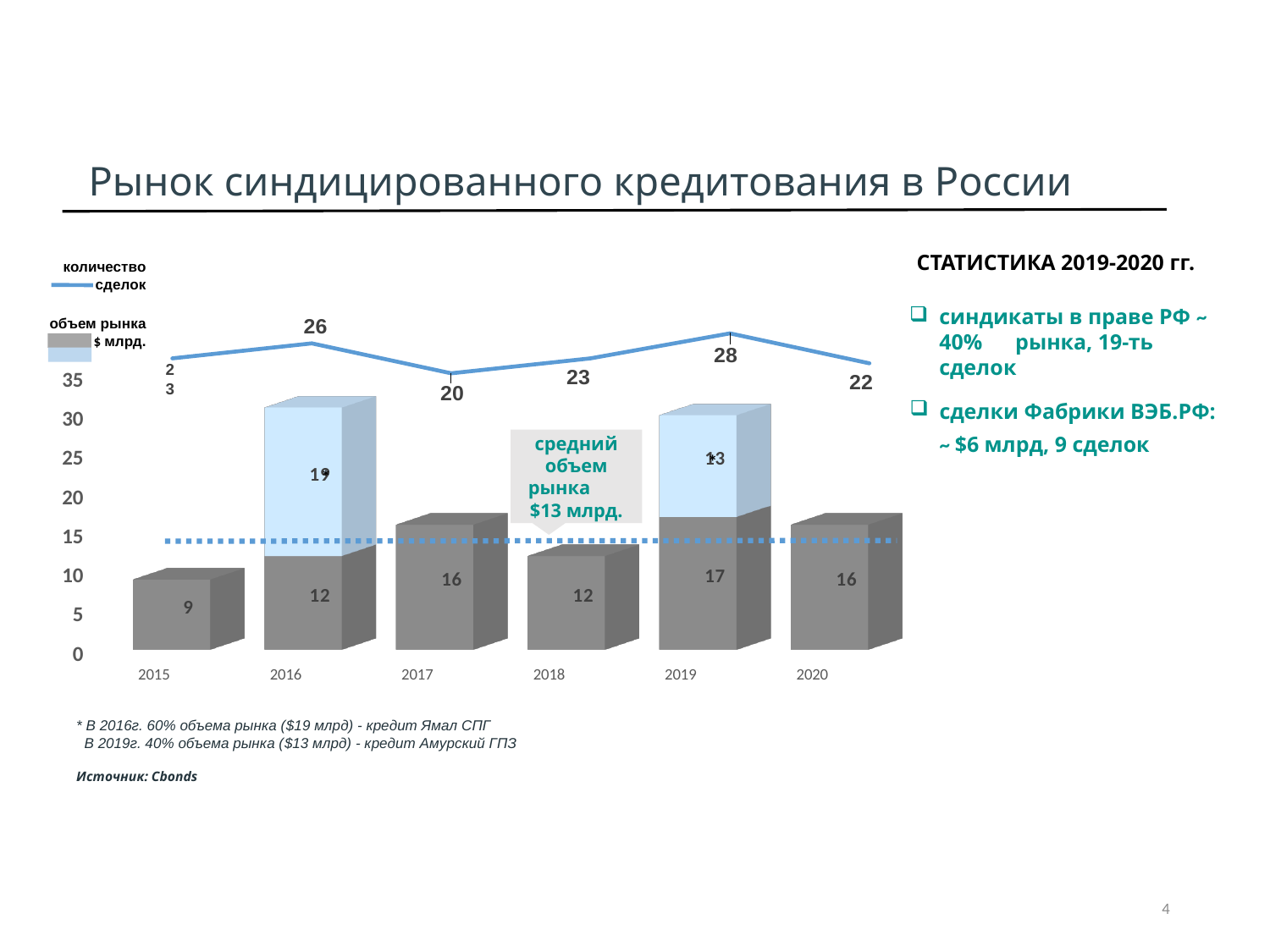
What is the light blue segment value on the 2016 bar? 19 What is the number of deals (количество сделок) in 2016? 26 What is the total of the stacked bar for 2019 (gray plus light blue)? 30 Is the gray bar value for 2017 larger or smaller than the gray bar value for 2018? larger Which year has the lowest gray market volume bar? 2015 Which year has the highest number of deals on the line? 2019 Which year has the lowest number of deals on the line? 2017 What value does the dotted horizontal line labelled 'средний объем рынка' represent? $13 млрд. How many years are shown on the x axis? 6 What is the gray market volume bar value for 2015? 9 What is the difference between the number of deals in 2019 and in 2020? 6 What is the number of deals (количество сделок) in 2019? 28